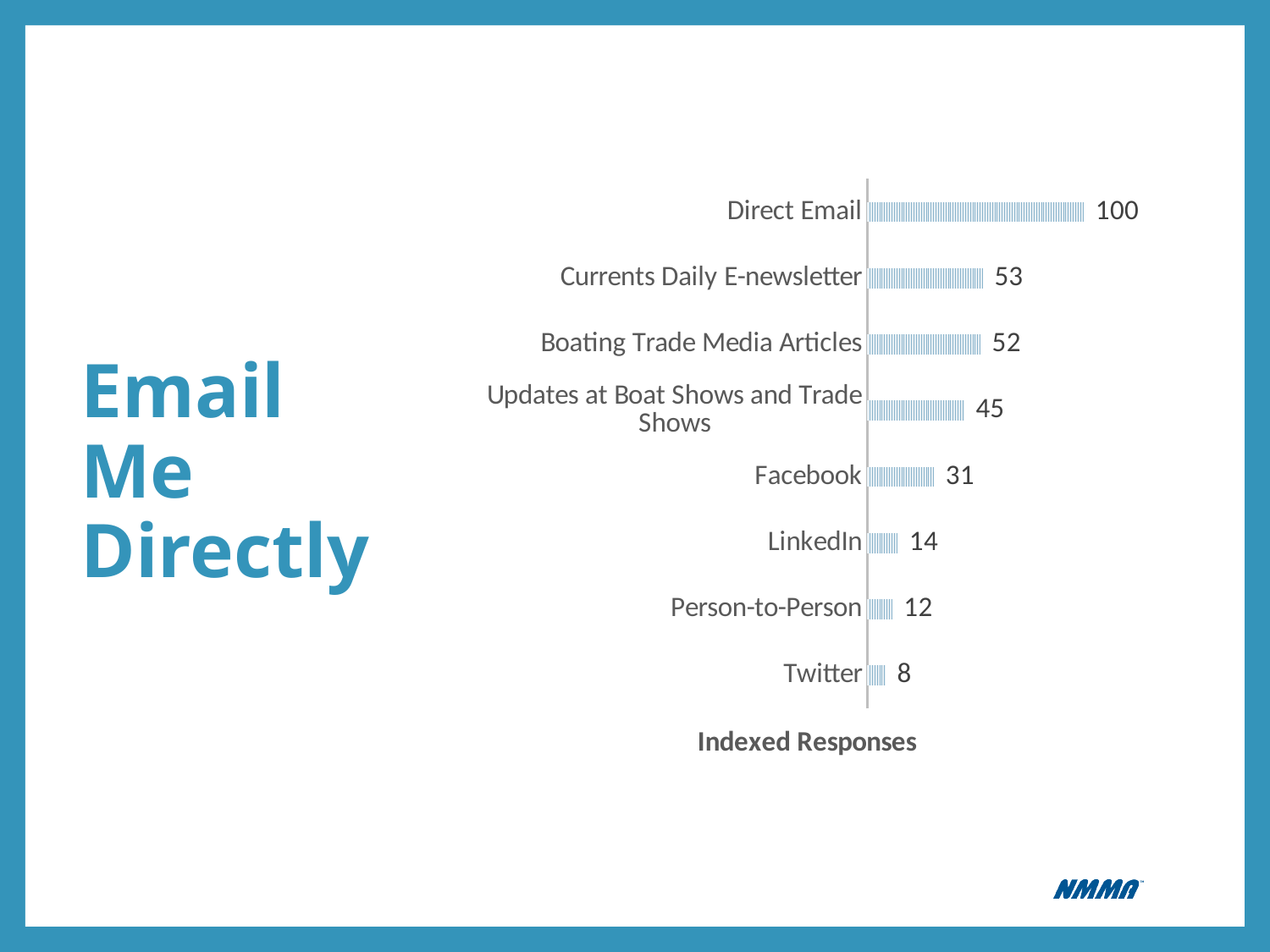
Which category has the lowest indexed response? Twitter What kind of chart is shown on the slide? Bar chart What is the difference between the values for Direct Email and Currents Daily E-newsletter? 47 What is the difference between the values for LinkedIn and Person-to-Person? 2 How many categories are shown in the chart? 8 Which has a larger value, Boating Trade Media Articles or Updates at Boat Shows and Trade Shows? Boating Trade Media Articles What is the label shown below the chart? Indexed Responses What is the indexed response value for Facebook? 31 What is the indexed response value for Direct Email? 100 What is the indexed response value for Updates at Boat Shows and Trade Shows? 45 Which has a larger value, Facebook or LinkedIn? Facebook Which category has the highest indexed response? Direct Email